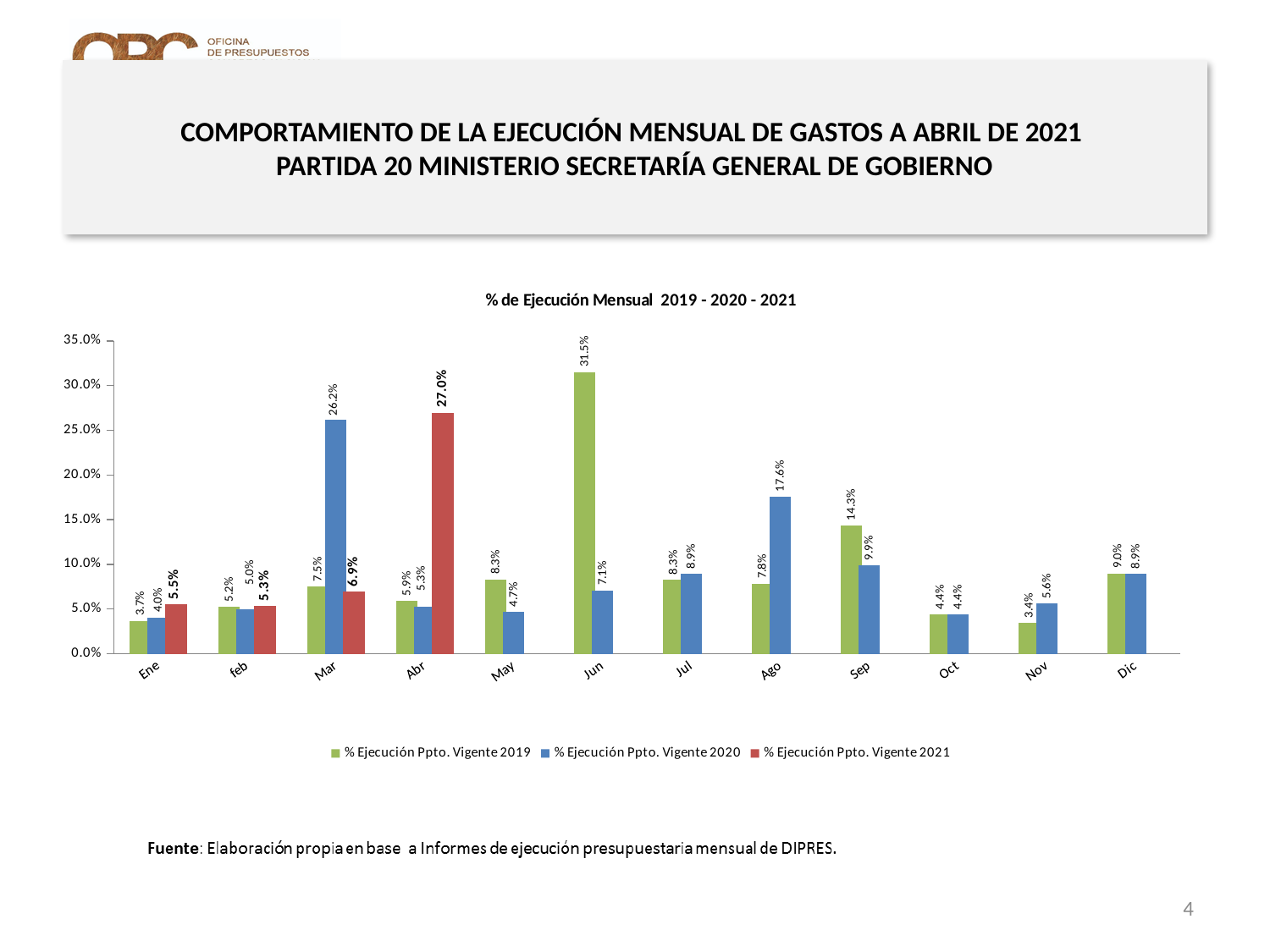
What is the value for Mar in the % Ejecución Ppto. Vigente 2020 series? 26.2% Which is larger for Sep: the 2019 value or the 2020 value? 2019 Which month has the lowest value in the % Ejecución Ppto. Vigente 2019 series? Nov What is the value for Jun in the % Ejecución Ppto. Vigente 2019 series? 31.5% How many months are shown on the x axis? 12 What is the value for Ene in the % Ejecución Ppto. Vigente 2021 series? 5.5% What kind of chart is shown on the slide? Bar chart What is the difference between the 2020 and 2019 values for Ago? 9.8% What is the title of the chart? % de Ejecución Mensual 2019 - 2020 - 2021 Which month has the highest value in the % Ejecución Ppto. Vigente 2019 series? Jun What is the value for Abr in the % Ejecución Ppto. Vigente 2021 series? 27.0% How many series does the legend list? 3